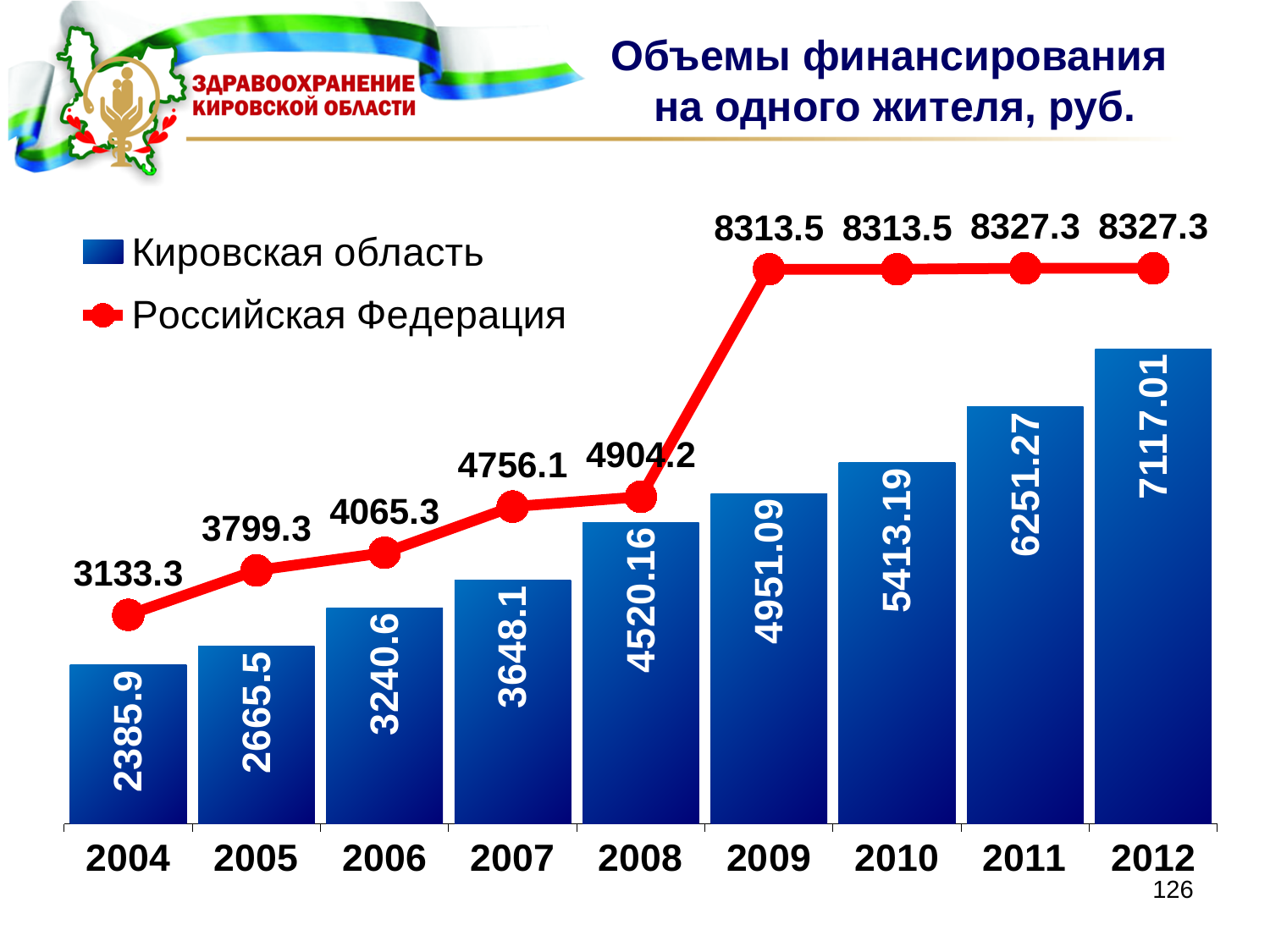
What is the difference between the Кировская область values for 2012 and 2004? 4731.11 What kind of chart is used for the Кировская область series? Bar chart Do the values for Кировская область rise or fall from 2004 to 2012? Rise How many years are shown on the x axis? 9 In which year is the value for Кировская область the highest? 2012 How many series does the legend list? 2 What is the value for Российская Федерация in 2007? 4756.1 In 2012, which series has the larger value: Кировская область or Российская Федерация? Российская Федерация What is the value for Кировская область in 2012? 7117.01 In which year is the value for Российская Федерация the lowest? 2004 What is the value for Кировская область in 2008? 4520.16 What is the difference between the Российская Федерация values for 2009 and 2008? 3409.3